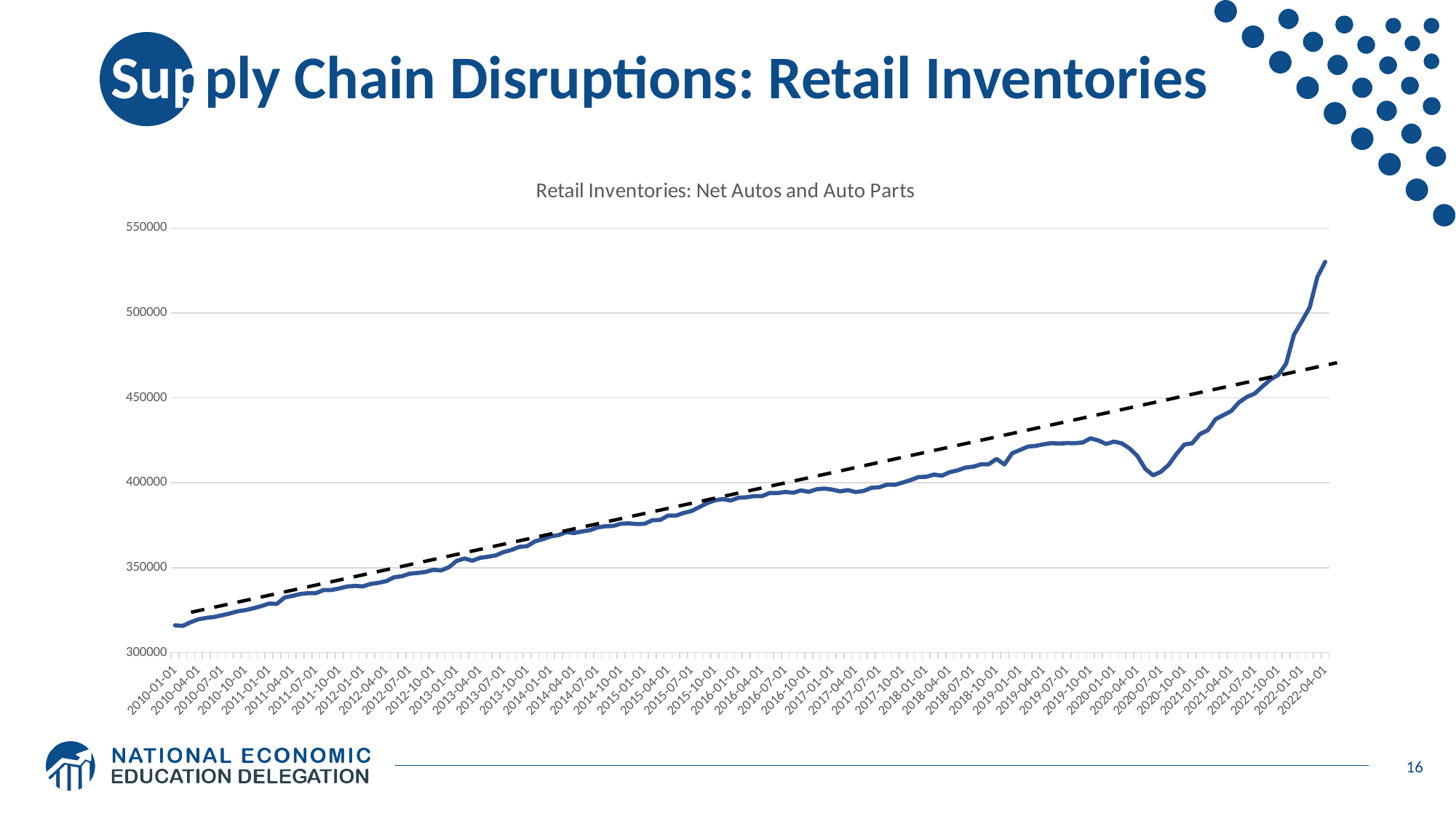
Overall, do the retail inventory values rise or fall from 2010-01-01 to 2022-04-01? Rise What kind of chart is shown on the slide? Line chart Is the value for 2020-07-01 greater or less than 450000? less Is the value for 2022-04-01 greater or less than 500000? greater Is the value for 2016-01-01 greater or less than 400000? less At which date does the solid line reach its highest value? 2022-04-01 Which is larger, the value for 2019-10-01 or the value for 2020-07-01? 2019-10-01 What is the title of the chart? Retail Inventories: Net Autos and Auto Parts What is the highest value shown on the vertical axis? 550000